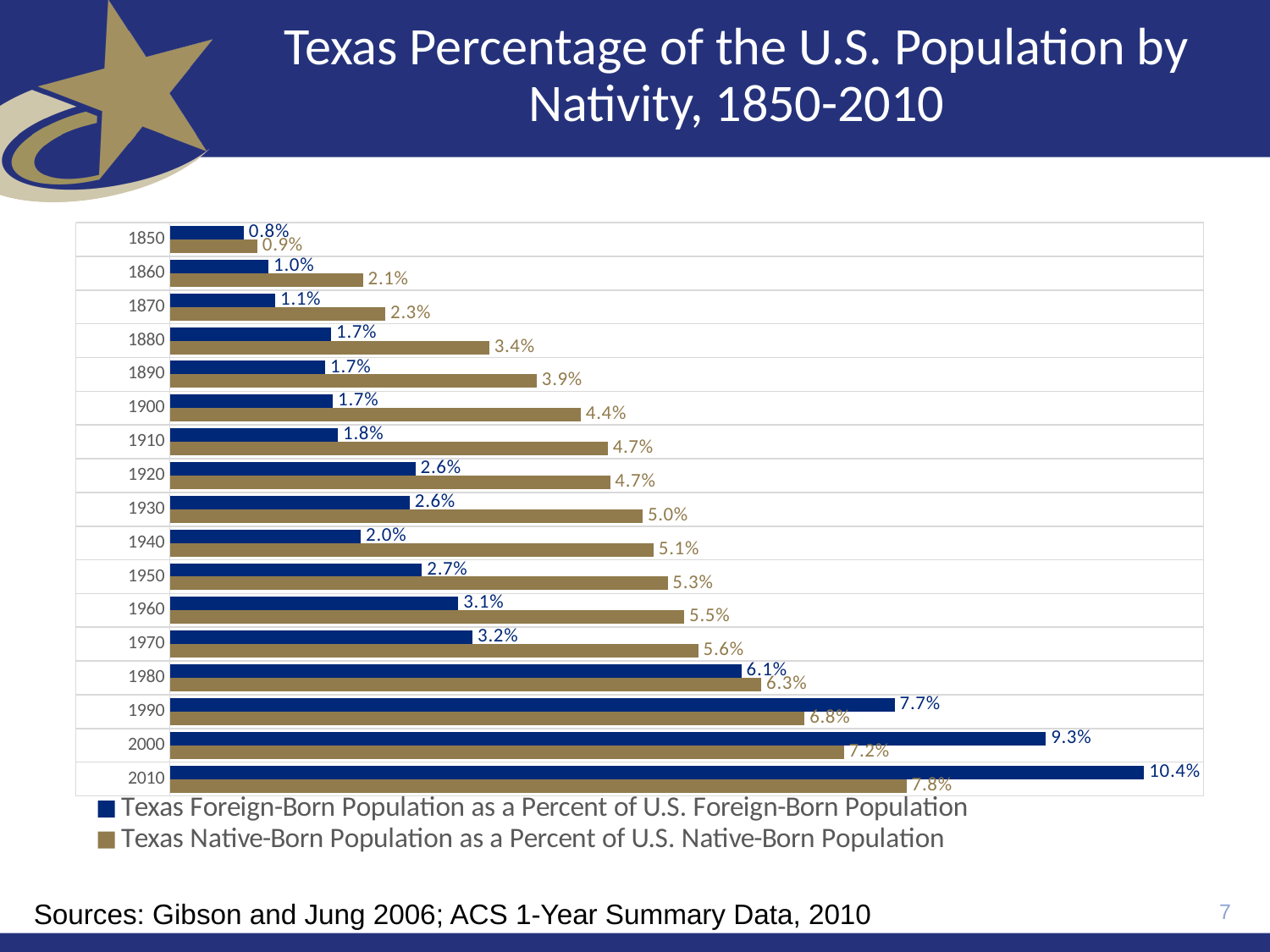
In 1970, which is larger: the Texas foreign-born share or the Texas native-born share? Texas native-born share In which year is the Texas foreign-born share of the U.S. foreign-born population highest? 2010 In which year is the Texas native-born share of the U.S. native-born population lowest? 1850 How many series does the legend list? 2 What is the Texas foreign-born population as a percent of the U.S. foreign-born population in 1940? 2.0% What is the Texas foreign-born population as a percent of the U.S. foreign-born population in 2010? 10.4% How many years (categories) are shown on the chart? 17 What is the Texas native-born population as a percent of the U.S. native-born population in 1900? 4.4% What is the difference between the foreign-born and native-born percentages in 2000? 2.1% Does the Texas native-born share of the U.S. native-born population generally rise or fall from 1850 to 2010? rise What colour are the bars for the Texas foreign-born population series? blue What kind of chart is shown on the slide? bar chart